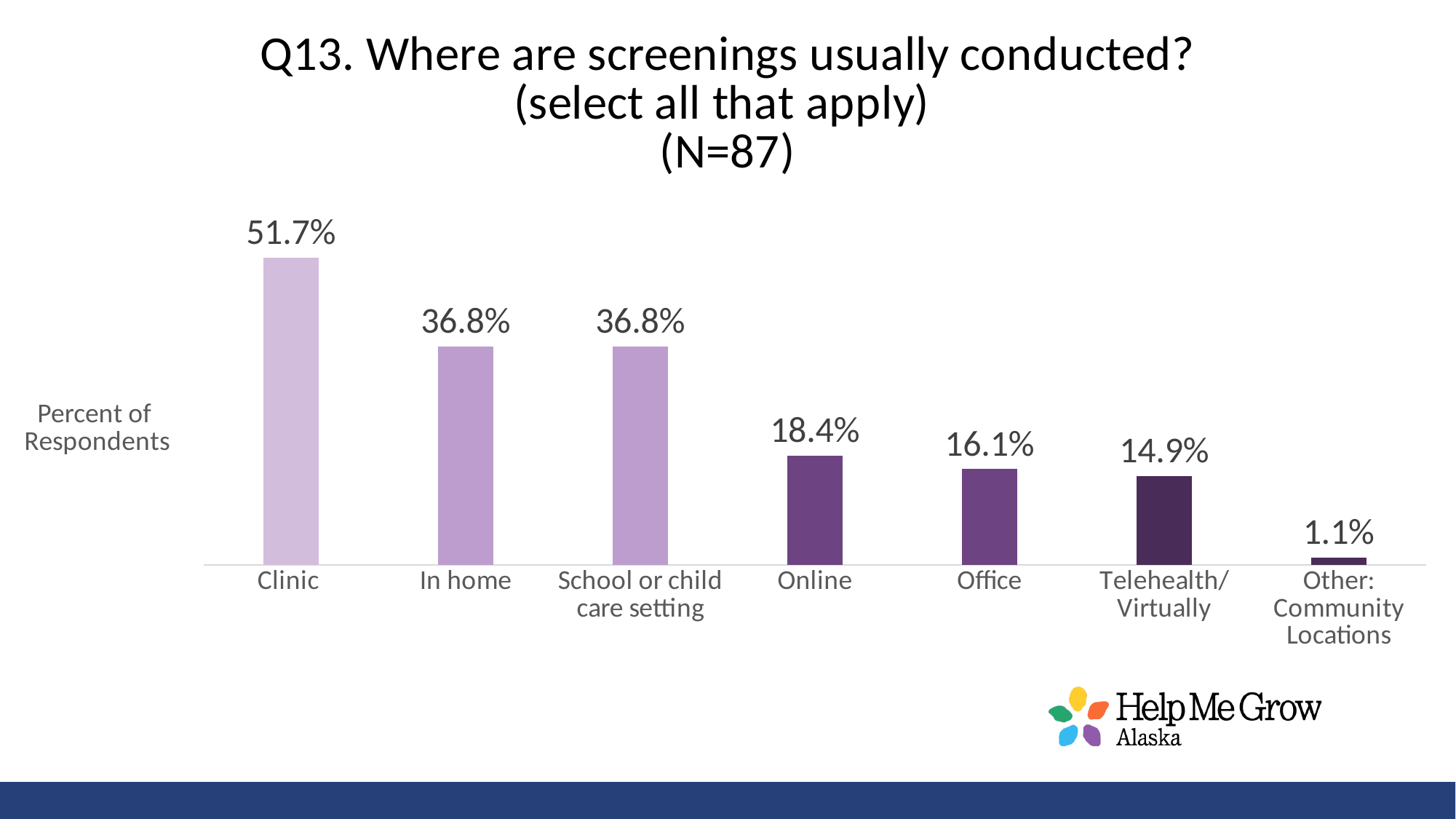
What percent of respondents selected Telehealth/Virtually? 14.9% Which category has the lowest value? Other: Community Locations How many categories are shown on the chart? 7 What is the difference between the values for Clinic and In home? 14.9% Which category has the highest value? Clinic What is the value for Other: Community Locations? 1.1% What is the value for Online? 18.4% What is the difference between the values for Online and Office? 2.3% Which is larger, the value for Office or the value for Telehealth/Virtually? Office What kind of chart is shown on the slide? Bar chart What is the label on the vertical axis of the chart? Percent of Respondents What percent of respondents selected Clinic? 51.7%